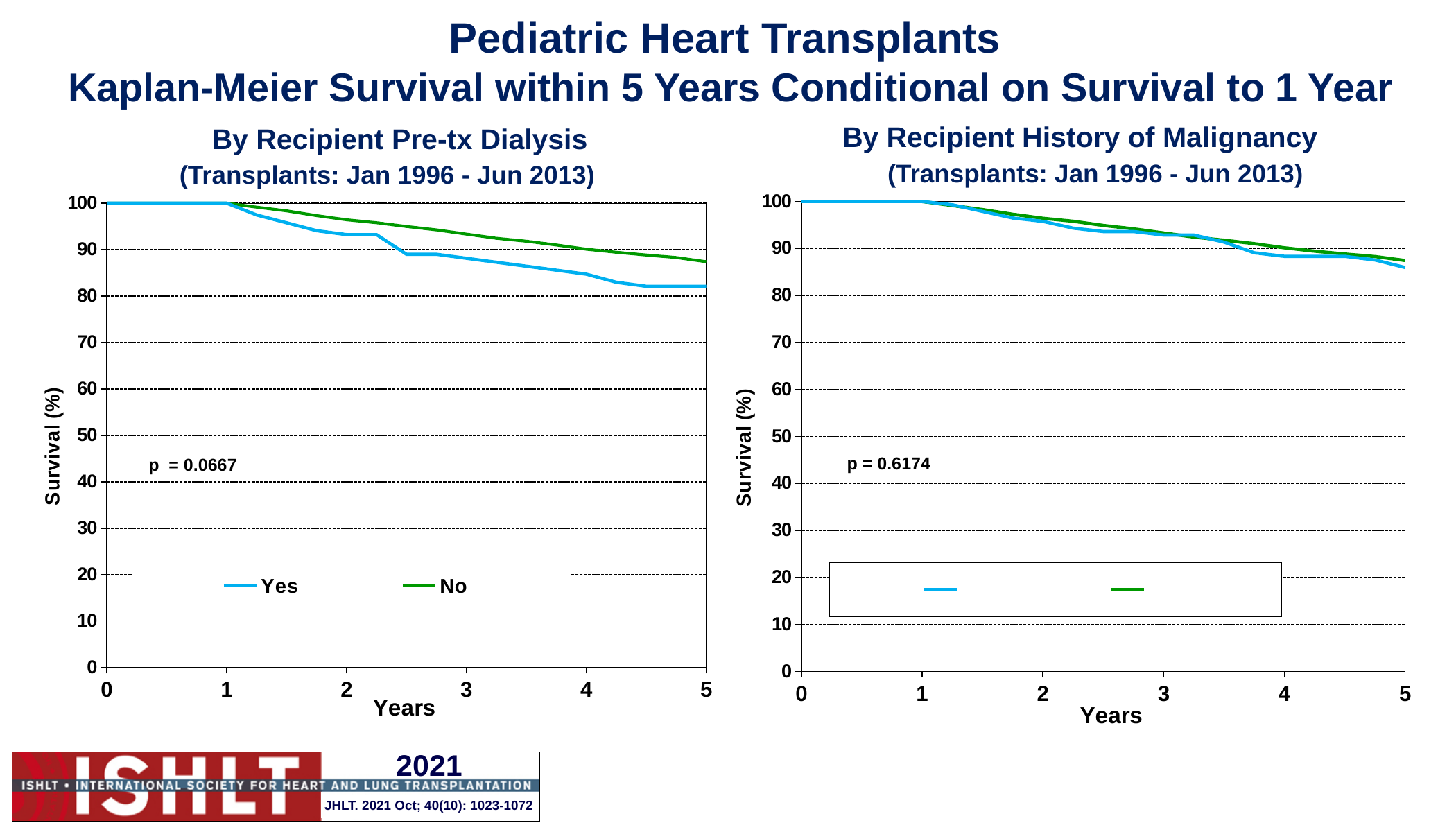
In the left chart, 'By Recipient Pre-tx Dialysis', is the survival value for the 'Yes' series at 5 years greater or less than 90? less In the left chart, 'By Recipient Pre-tx Dialysis', is the survival value for the 'No' series at 5 years greater or less than 80? greater What kind of chart is the left chart, 'By Recipient Pre-tx Dialysis'? Line chart In the right chart, 'By Recipient History of Malignancy', is the survival value of the blue line at 5 years greater or less than 90? less In the right chart, 'By Recipient History of Malignancy', do the survival curves rise or fall as years increase from 1 to 5? Fall What p-value is printed on the left chart, 'By Recipient Pre-tx Dialysis'? p = 0.0667 In the left chart, 'By Recipient Pre-tx Dialysis', which series has the higher survival at 5 years, 'Yes' or 'No'? No In the left chart, 'By Recipient Pre-tx Dialysis', which series is shown in blue? Yes In the left chart, 'By Recipient Pre-tx Dialysis', do the survival curves rise or fall as years increase from 1 to 5? Fall How many series does the legend of the left chart, 'By Recipient Pre-tx Dialysis', list? 2